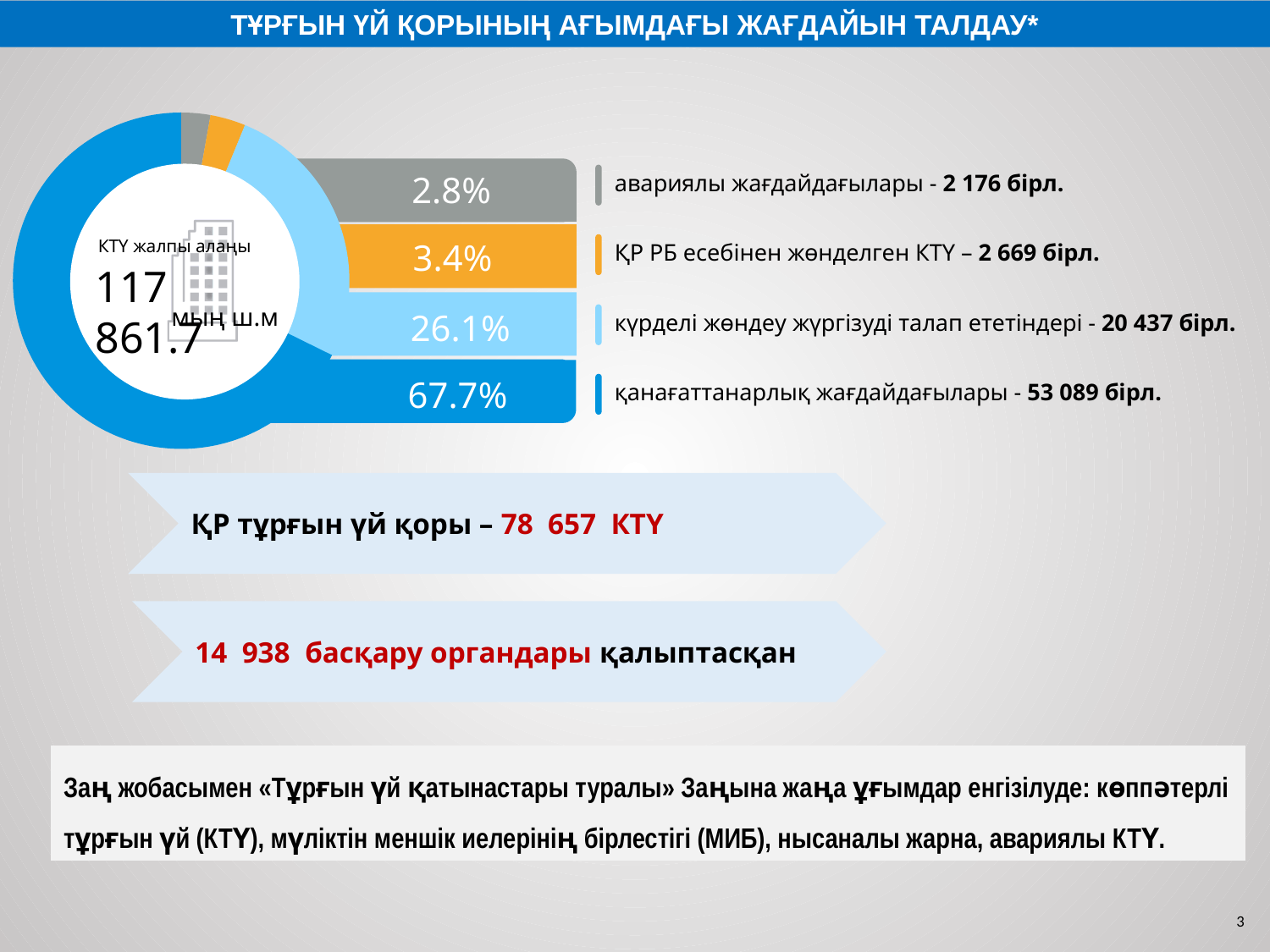
What is the difference in percentage points between the 67.7% segment and the 26.1% segment? 41.6 What percentage share is shown for the segment labelled 'қанағаттанарлық жағдайдағылары'? 67.7% How many units (бірл.) are listed for 'аварийлы жағдайдағылары'? 2 176 бірл. What percentage share is shown for the segment labelled 'күрделі жөндеу жүргізуді талап ететіндері'? 26.1% What total value is shown in the centre of the donut chart for 'КТҮ жалпы алаңы'? 117 861.7 мың ш.м What percentage share is shown for the segment labelled 'аварийлы жағдайдағылары'? 2.8% Which segment of the donut chart has the smallest share? аварийлы жағдайдағылары (2.8%) Which segment of the donut chart has the largest share? қанағаттанарлық жағдайдағылары (67.7%) What kind of chart is shown on the slide? Donut (pie) chart How many segments does the donut chart have? 4 How many units (бірл.) are listed for 'күрделі жөндеу жүргізуді талап ететіндері'? 20 437 бірл.